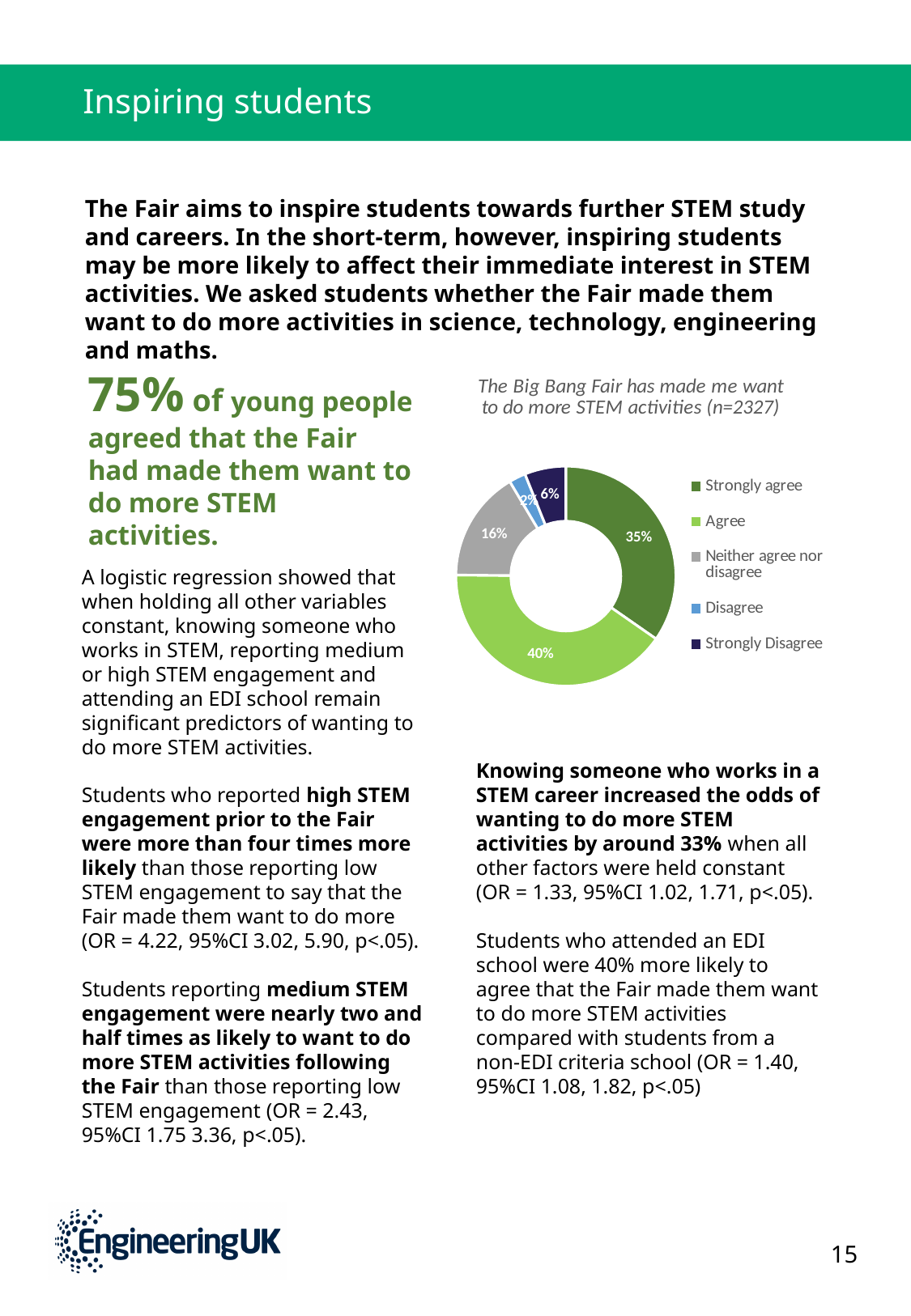
What percentage of respondents selected "Strongly Disagree"? 6% What is the combined percentage of "Strongly agree" and "Agree"? 75% What share of respondents chose "Neither agree nor disagree"? 16% What is the sample size (n) given in the chart title? 2327 What is the difference in percentage points between "Agree" and "Strongly agree"? 5 What percentage of respondents selected "Strongly agree"? 35% Which response category has the largest share in the chart? Agree Which is larger: the share for "Strongly Disagree" or the share for "Disagree"? Strongly Disagree How many response categories does the chart's legend list? 5 Which response category has the smallest share in the chart? Disagree What percentage of respondents selected "Agree" in the donut chart? 40% What type of chart is used to show the responses? Donut (pie) chart